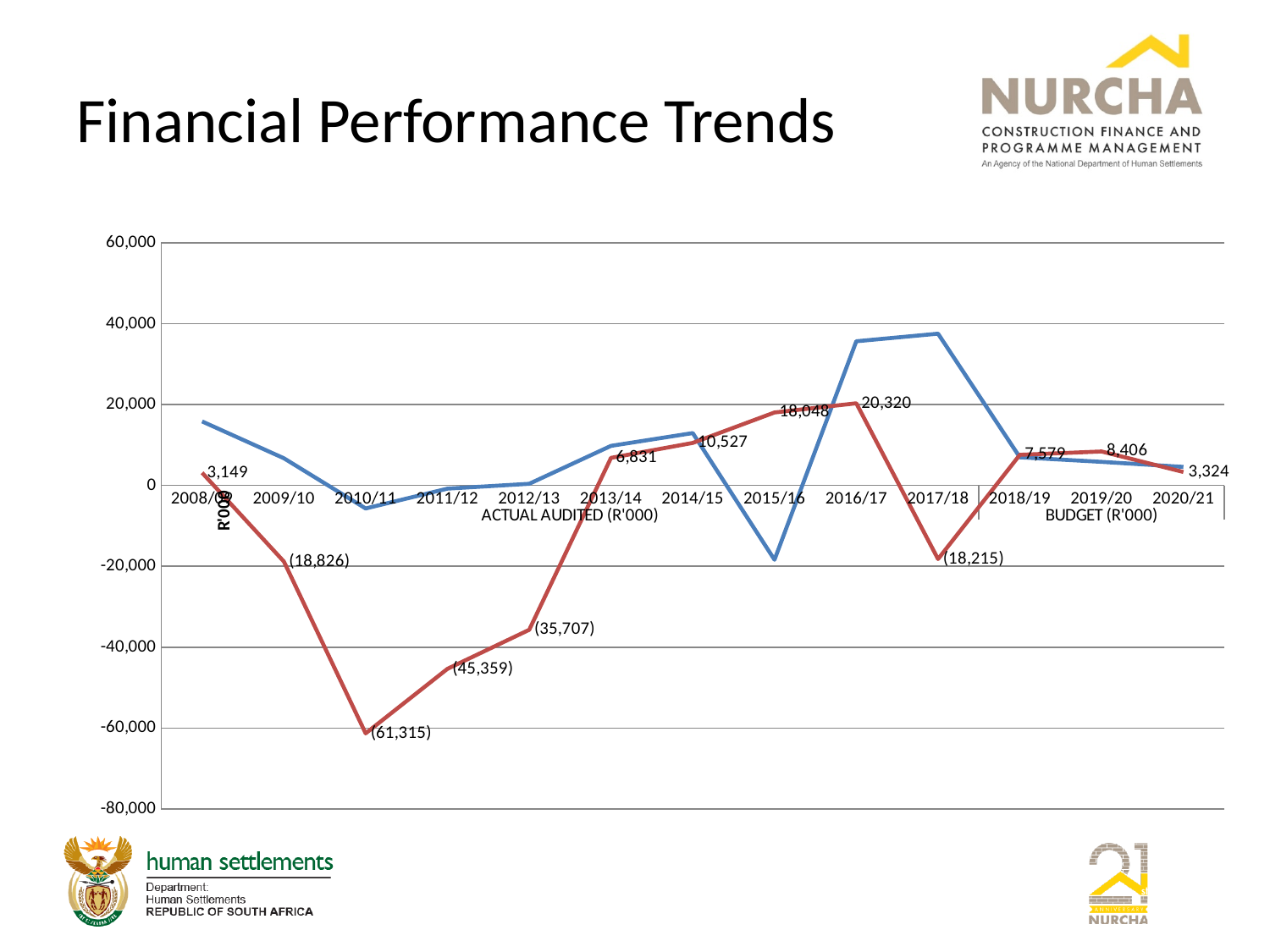
What type of chart is shown on the slide? line chart In which year does the red line reach its lowest labelled value? 2010/11 What is the labelled value of the red line for 2019/20? 8,406 Which is larger on the red line: the value for 2018/19 or the value for 2020/21? 2018/19 What is the difference between the red line's values for 2016/17 (20,320) and 2015/16 (18,048)? 2,272 What is the title of the chart on the slide? Financial Performance Trends How many financial years are plotted along the x axis of the chart? 13 Is the value of the blue line for 2017/18 greater or less than 20,000? greater What is the labelled value of the red line for 2016/17? 20,320 What is the labelled value of the red line for 2010/11? (61,315) Does the red line rise or fall from 2010/11 to 2016/17? rise In which year does the red line reach its highest labelled value? 2016/17